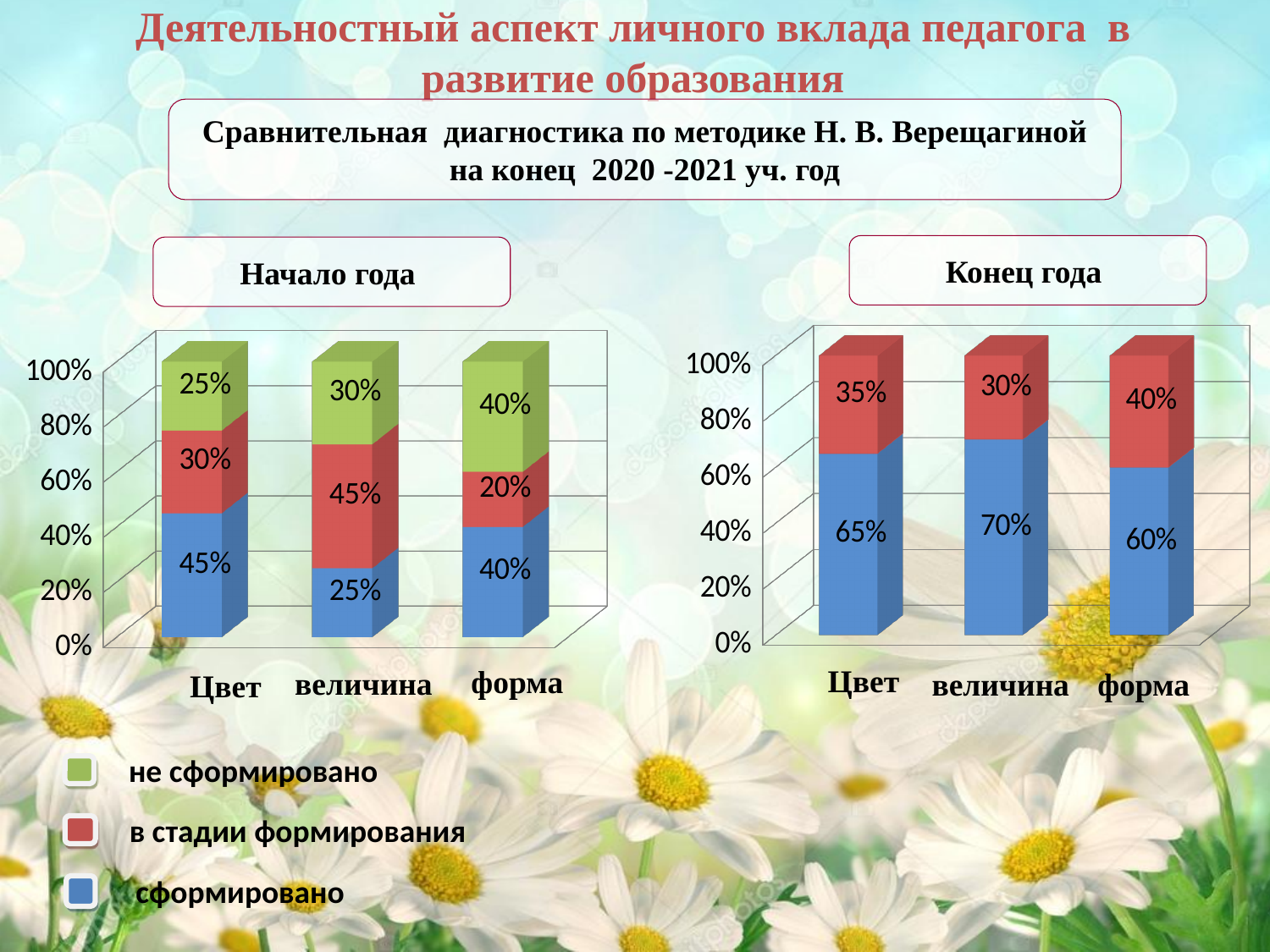
In the 'Конец года' chart, what is the value of the 'в стадии формирования' segment for 'форма'? 40% In the 'Конец года' chart, which category has the highest 'сформировано' value? величина What type of chart is the 'Конец года' chart? Stacked bar chart In the 'Конец года' chart, is the 'сформировано' value for 'Цвет' or for 'форма' larger? Цвет In the 'Начало года' chart, what is the value of the 'в стадии формирования' segment for 'величина'? 45% In the 'Начало года' chart, what is the value of the 'не сформировано' segment for 'форма'? 40% How many series does the legend list? 3 In the 'Конец года' chart, what is the value of the 'сформировано' segment for 'величина'? 70% In the 'Начало года' chart, which category has the lowest 'сформировано' value? величина What is the difference between the 'сформировано' value for 'Цвет' in the 'Конец года' chart and in the 'Начало года' chart? 20% How many categories are shown on the x axis of the 'Начало года' chart? 3 In the 'Начало года' chart, what is the value of the 'сформировано' segment for 'Цвет'? 45%